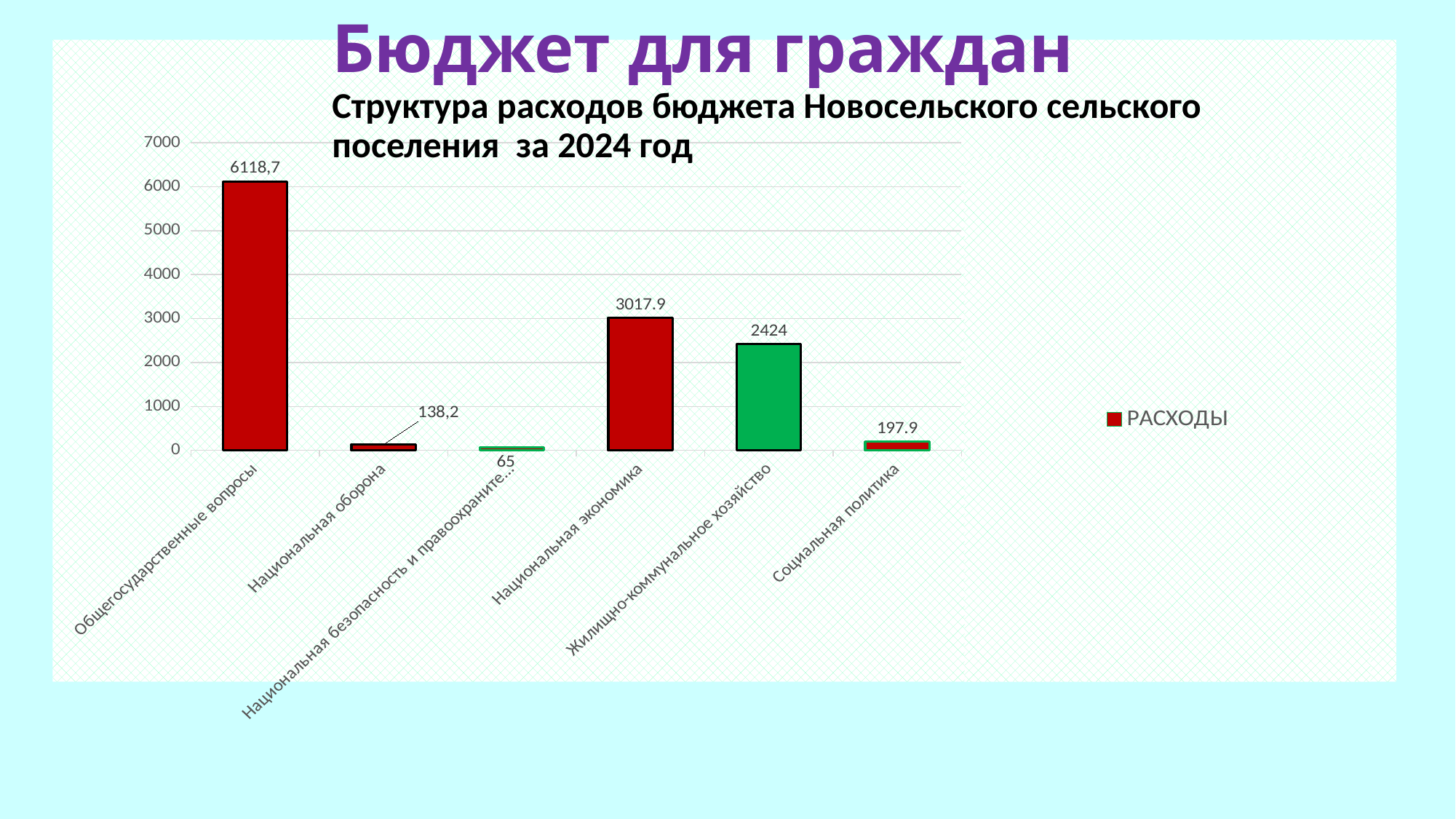
What is the lowest value shown in the chart? 65 What is the value for Национальная экономика? 3017.9 What is the value for Жилищно-коммунальное хозяйство? 2424 What is the difference between the values for Национальная экономика and Жилищно-коммунальное хозяйство? 593.9 What is the value for Социальная политика? 197.9 What is the value for Общегосударственные вопросы? 6118,7 What is the name of the series listed in the legend? РАСХОДЫ Which category has the highest value? Общегосударственные вопросы What type of chart is shown on the slide? bar chart How many categories are shown on the x axis? 6 Which is larger, the value for Социальная политика or the value for Национальная оборона? Социальная политика What is the value for Национальная оборона? 138,2